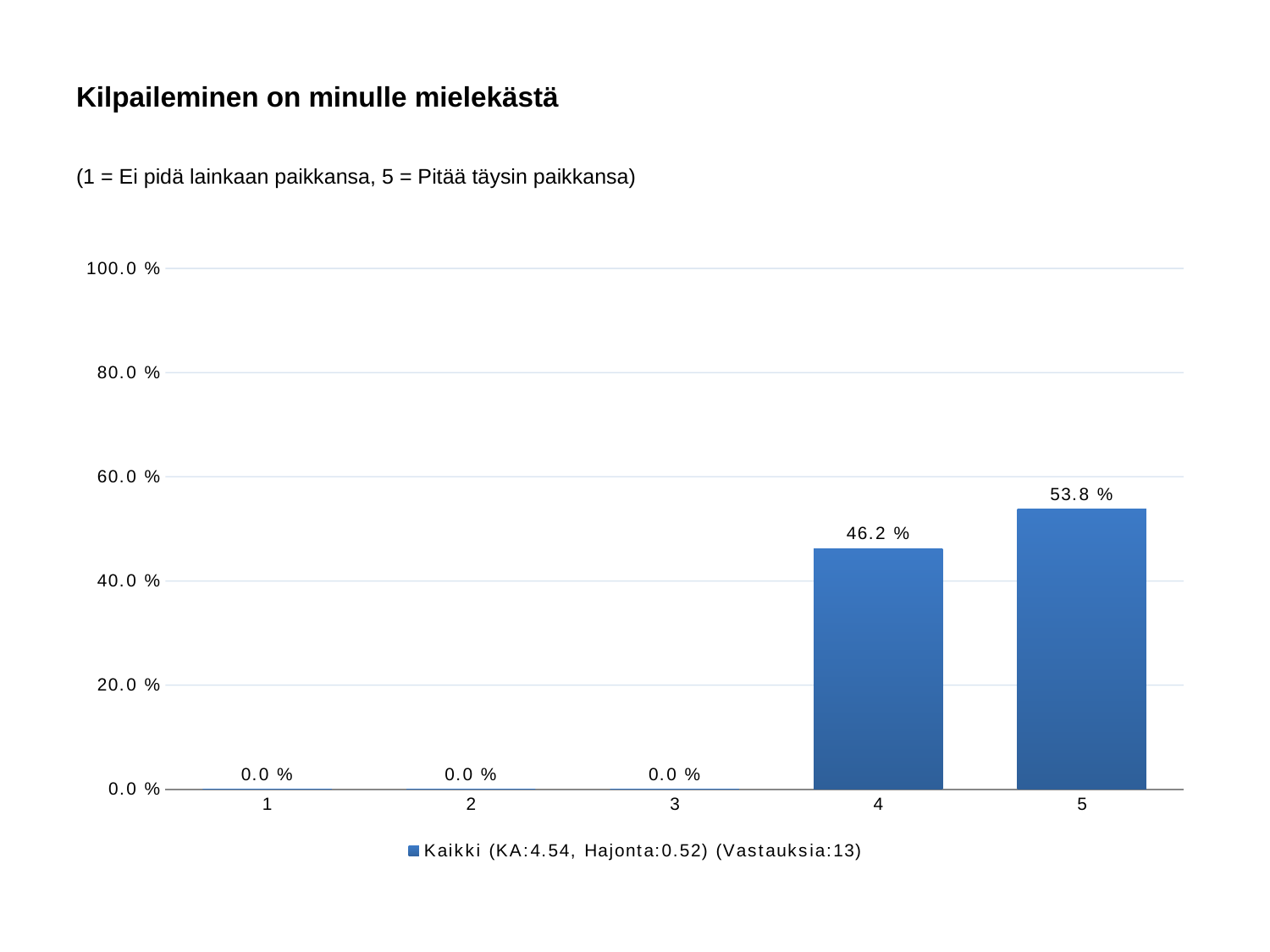
What is the value for category 1? 0.0 % What is the difference between the values for category 5 and category 4? 7.6 % What is the value for category 4? 46.2 % How many series does the legend list? 1 What is the title of the slide? Kilpaileminen on minulle mielekästä Which is larger, the value for category 4 or the value for category 5? 5 Which category has the highest value? 5 Is the value for category 5 greater or less than 60.0 %? less What is the value for category 5? 53.8 % How many categories are shown on the x axis? 5 Is the value for category 4 greater or less than 40.0 %? greater What kind of chart is shown on the slide? bar chart